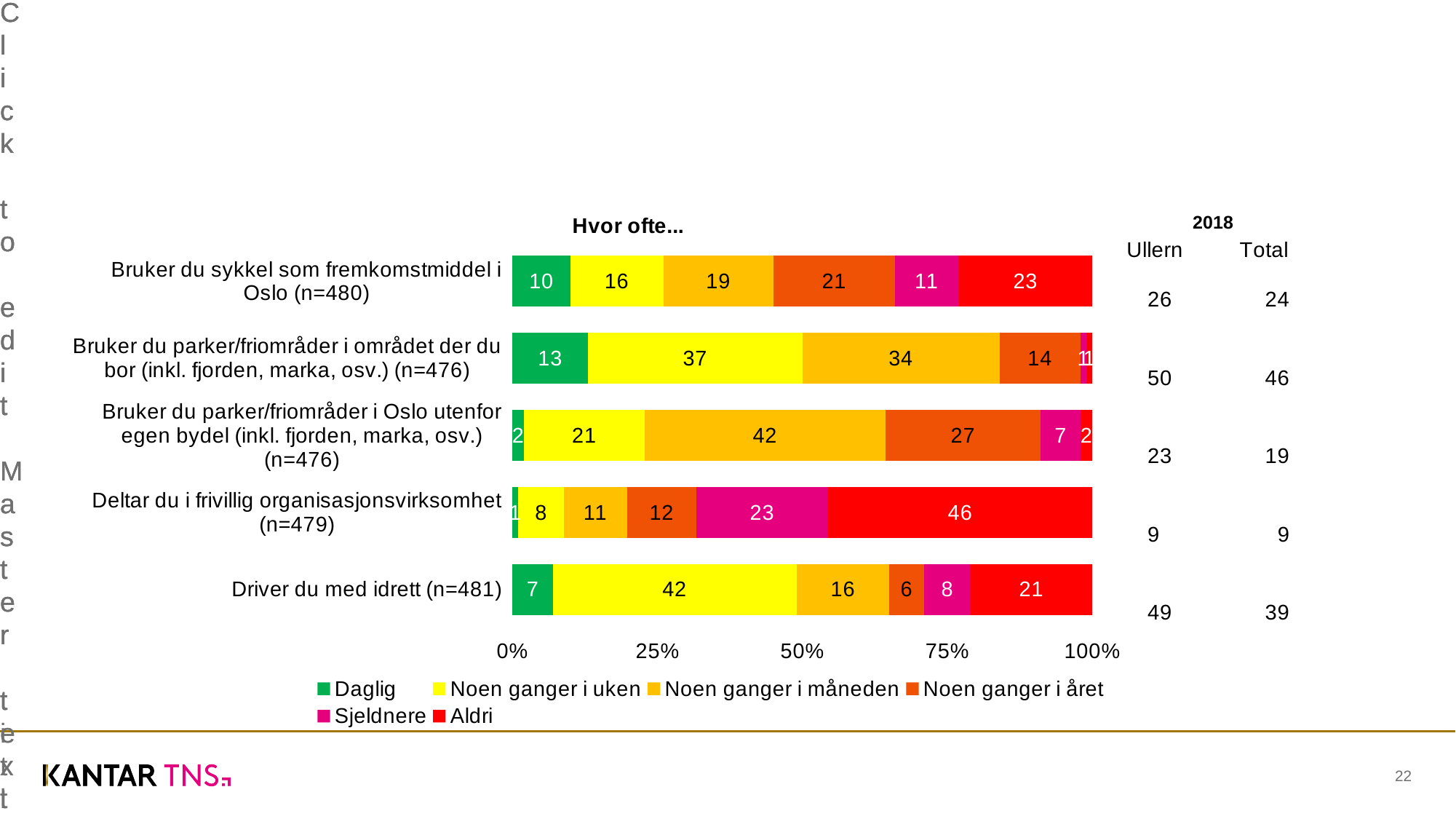
What is the 'Daglig' value for 'Bruker du sykkel som fremkomstmiddel i Oslo (n=480)'? 10 What is the 'Aldri' value for 'Deltar du i frivillig organisasjonsvirksomhet (n=479)'? 46 How many series does the legend list? 6 What is the 'Noen ganger i uken' value for 'Driver du med idrett (n=481)'? 42 What is the title of the chart? Hvor ofte... Which is larger: the 'Sjeldnere' value for 'Bruker du sykkel som fremkomstmiddel i Oslo (n=480)' or for 'Driver du med idrett (n=481)'? Bruker du sykkel som fremkomstmiddel i Oslo (n=480) How many question categories are plotted in the chart? 5 What is the 'Noen ganger i måneden' value for 'Bruker du parker/friområder i Oslo utenfor egen bydel (inkl. fjorden, marka, osv.) (n=476)'? 42 Which category has the highest 'Daglig' value? Bruker du parker/friområder i området der du bor (inkl. fjorden, marka, osv.) (n=476) What is the difference between the 'Aldri' values for 'Deltar du i frivillig organisasjonsvirksomhet (n=479)' and 'Driver du med idrett (n=481)'? 25 What kind of chart is shown on the slide? Stacked bar chart Which category has the lowest 'Aldri' value? Bruker du parker/friområder i området der du bor (inkl. fjorden, marka, osv.) (n=476)